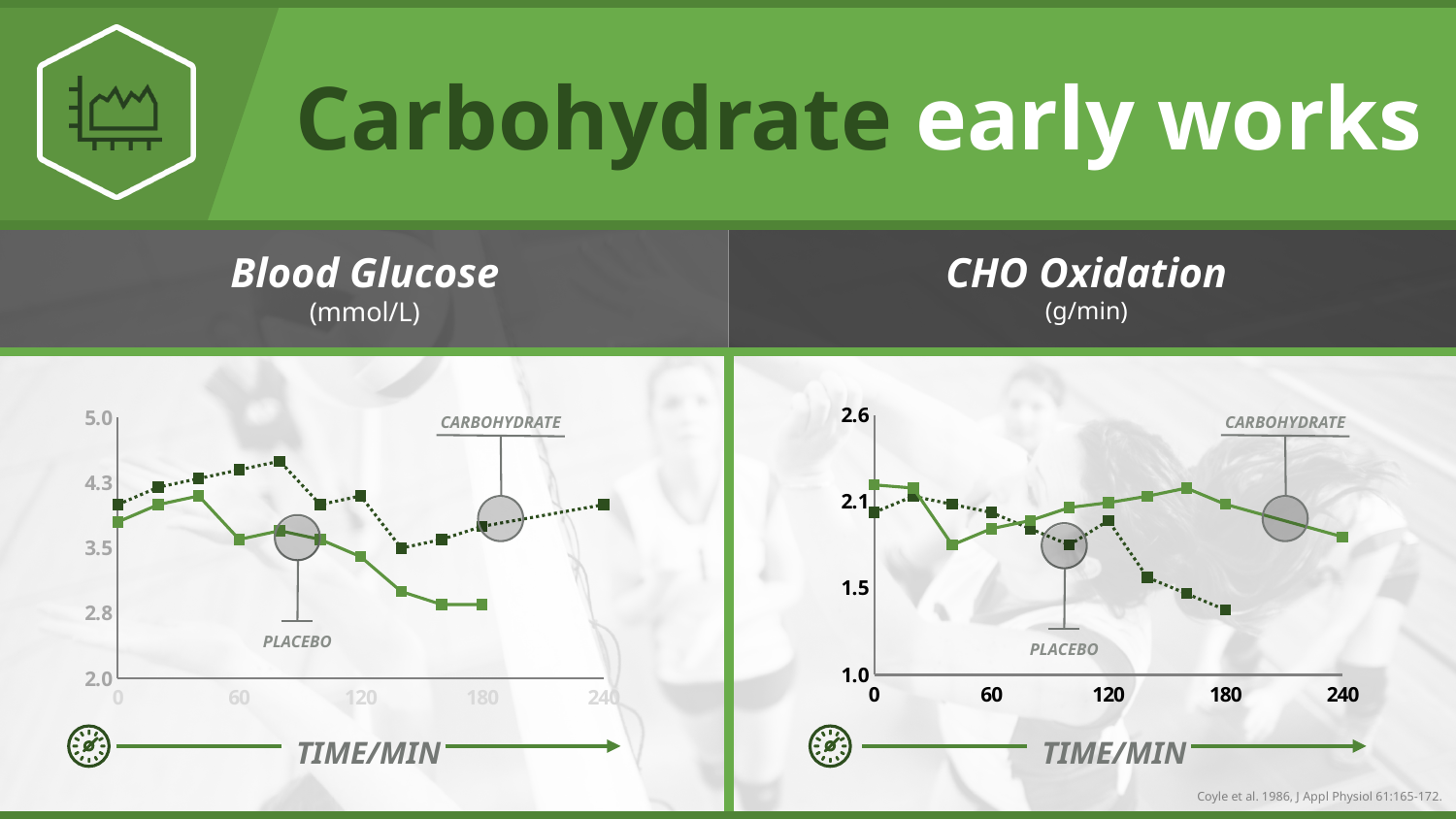
What unit is shown for the CHO Oxidation chart? g/min On the CHO Oxidation chart, is the Carbohydrate value at 180 min greater or less than 1.5? greater On the Blood Glucose chart, is the Carbohydrate value at 240 min greater or less than 3.5? greater What kind of chart is the Blood Glucose chart? line chart On the CHO Oxidation chart, which series has the higher value at 180 min, Carbohydrate or Placebo? Carbohydrate How many series are plotted on the Blood Glucose chart? 2 On the Blood Glucose chart, does the Placebo series rise or fall over time? fall On the CHO Oxidation chart, does the Carbohydrate series rise or fall over time? fall On the Blood Glucose chart, which series has the higher value at 180 min, Carbohydrate or Placebo? Carbohydrate What kind of chart is the CHO Oxidation chart? line chart On the Blood Glucose chart, is the Placebo value at 180 min greater or less than 3.5? less